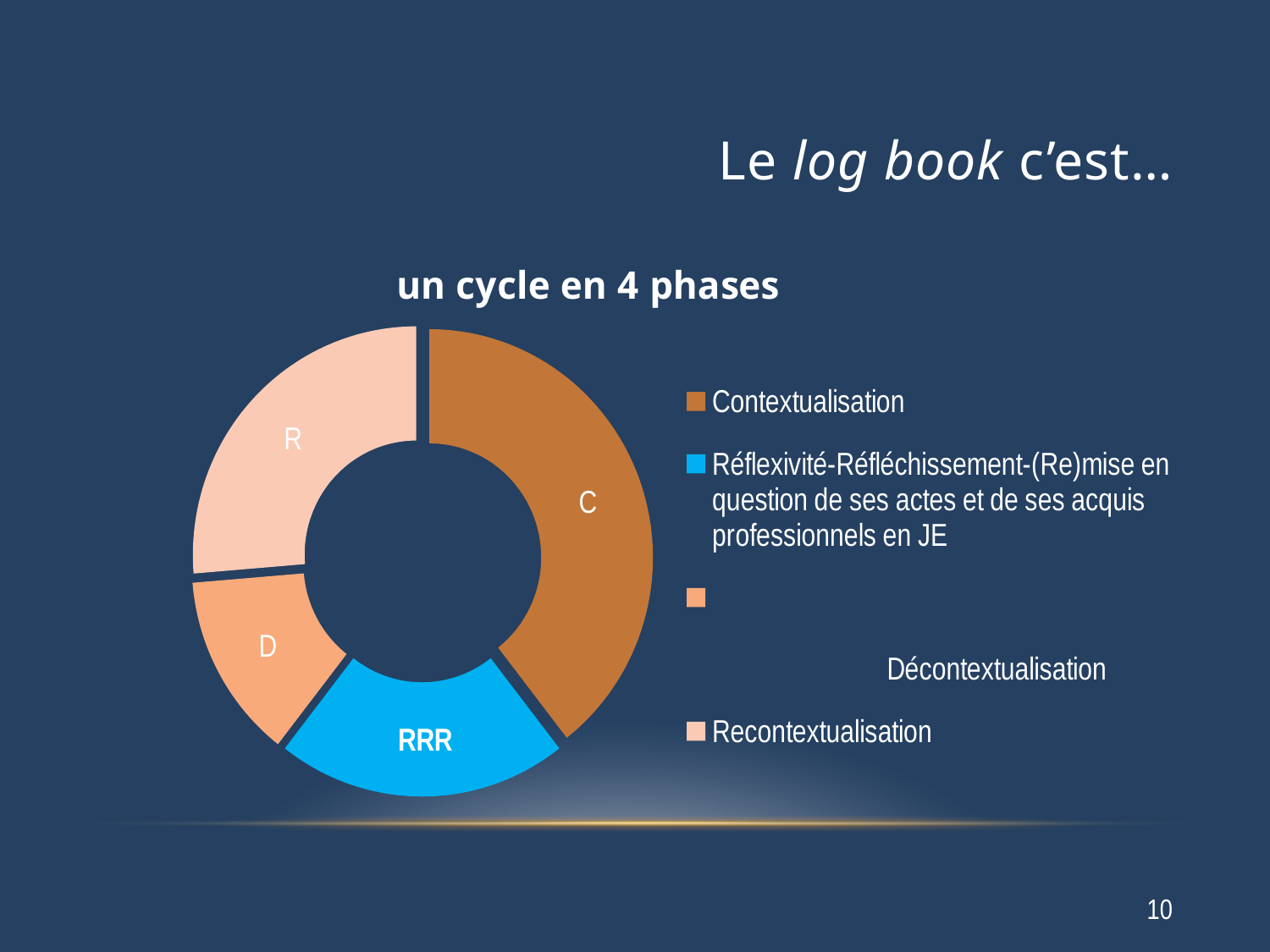
Which is larger, the segment labelled C or the segment labelled R? C Which is larger, the segment labelled R or the segment labelled D? R Which segment of the doughnut chart is the largest? C (Contextualisation) What is the title of the chart? un cycle en 4 phases Which is larger, the segment labelled C or the segment labelled RRR? C What kind of chart is shown on the slide? doughnut chart How many entries does the legend of the chart list? 4 How many segments does the doughnut chart have? 4 Which legend entry corresponds to the blue segment labelled RRR? Réflexivité-Réfléchissement-(Re)mise en question de ses actes et de ses acquis professionnels en JE